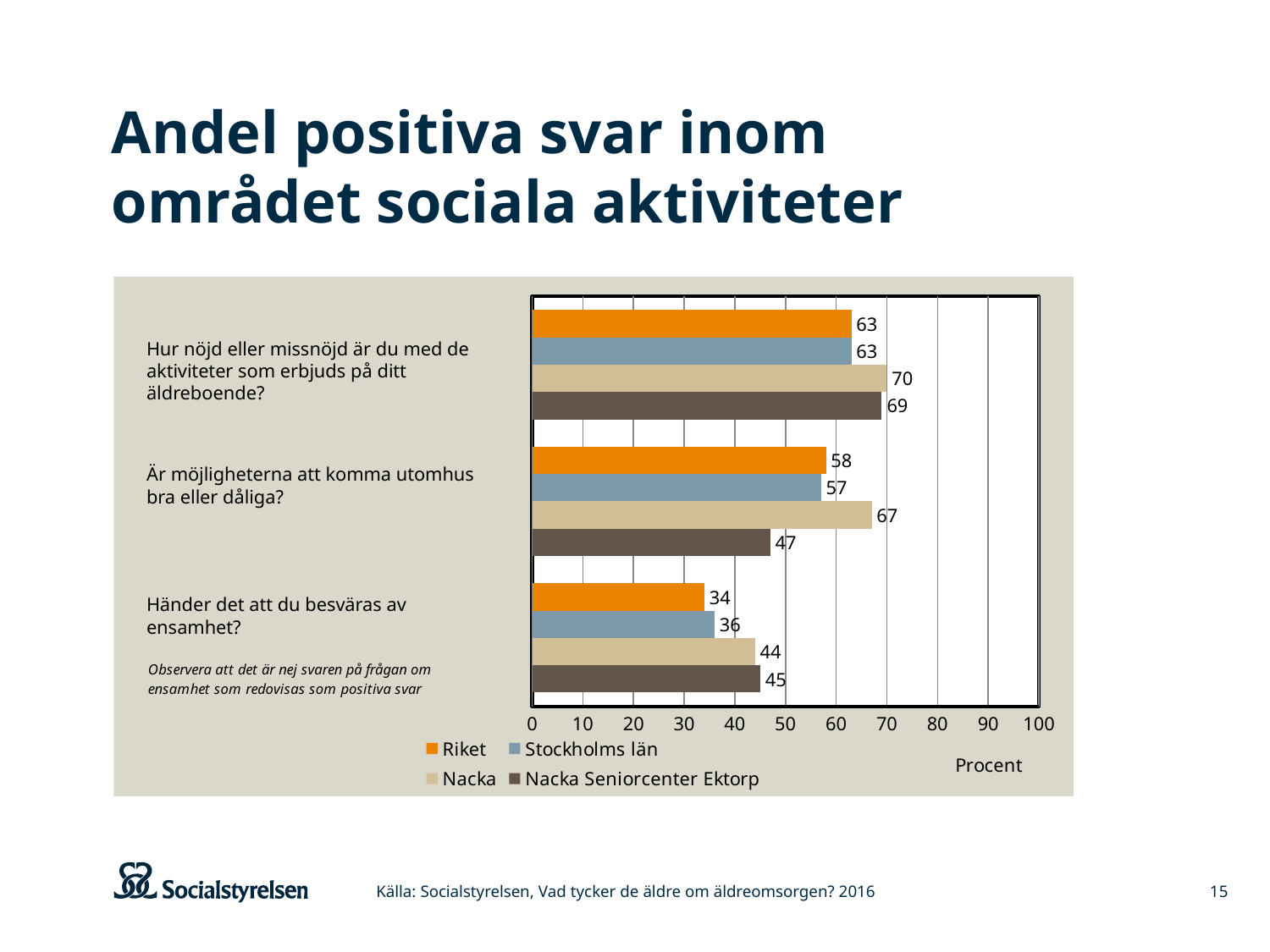
Which series has the lowest value on the question "Händer det att du besväras av ensamhet?"? Riket What is the value for Riket on the question "Händer det att du besväras av ensamhet?"? 34 On the question "Händer det att du besväras av ensamhet?", which is larger: the value for Nacka or the value for Stockholms län? Nacka How many question categories are plotted on the chart? 3 How many series does the legend list? 4 What kind of chart is shown on the slide? bar chart What is the value for Stockholms län on the question "Är möjligheterna att komma utomhus bra eller dåliga?"? 57 What is the value for Nacka Seniorcenter Ektorp on the question "Är möjligheterna att komma utomhus bra eller dåliga?"? 47 What is the value for Nacka on the question "Hur nöjd eller missnöjd är du med de aktiviteter som erbjuds på ditt äldreboende?"? 70 What label is shown on the horizontal axis of the chart? Procent What is the difference between Nacka and Nacka Seniorcenter Ektorp on the question "Är möjligheterna att komma utomhus bra eller dåliga?"? 20 Which series has the highest value on the question "Är möjligheterna att komma utomhus bra eller dåliga?"? Nacka